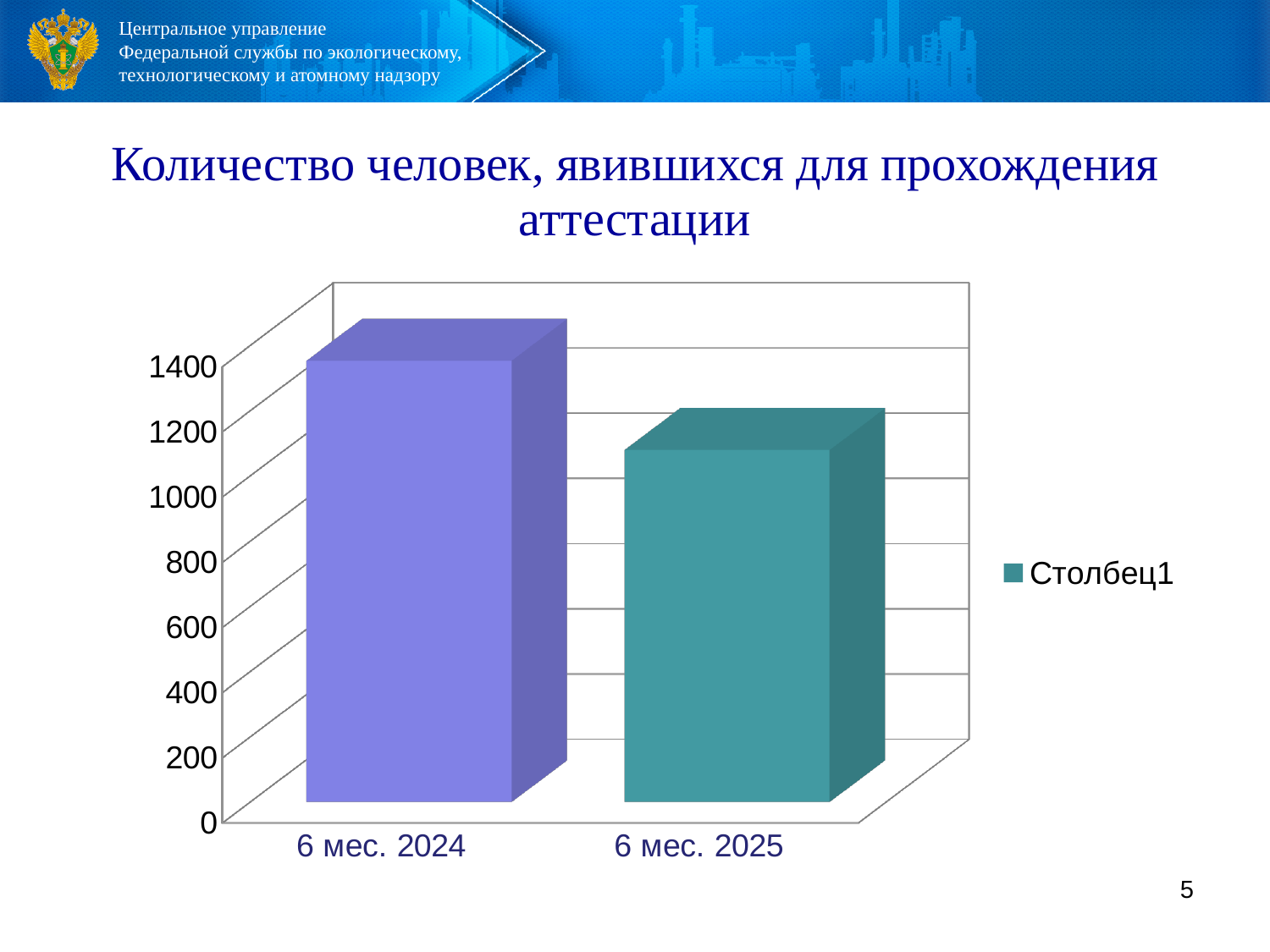
Is the value for 6 мес. 2025 greater or less than 1000? greater What kind of chart is shown on the slide? bar chart Which category has the highest value in the chart? 6 мес. 2024 Is the value for 6 мес. 2024 greater or less than 1200? greater What series name is shown in the chart legend? Столбец1 How many series does the chart legend list? 1 Which is larger, the value for 6 мес. 2024 or the value for 6 мес. 2025? 6 мес. 2024 How many categories are shown on the x axis of the chart? 2 Which category has the lowest value in the chart? 6 мес. 2025 What is the title of the chart on the slide? Количество человек, явившихся для прохождения аттестации Is the value for 6 мес. 2025 greater or less than 1200? less Do the values rise or fall from 6 мес. 2024 to 6 мес. 2025? fall